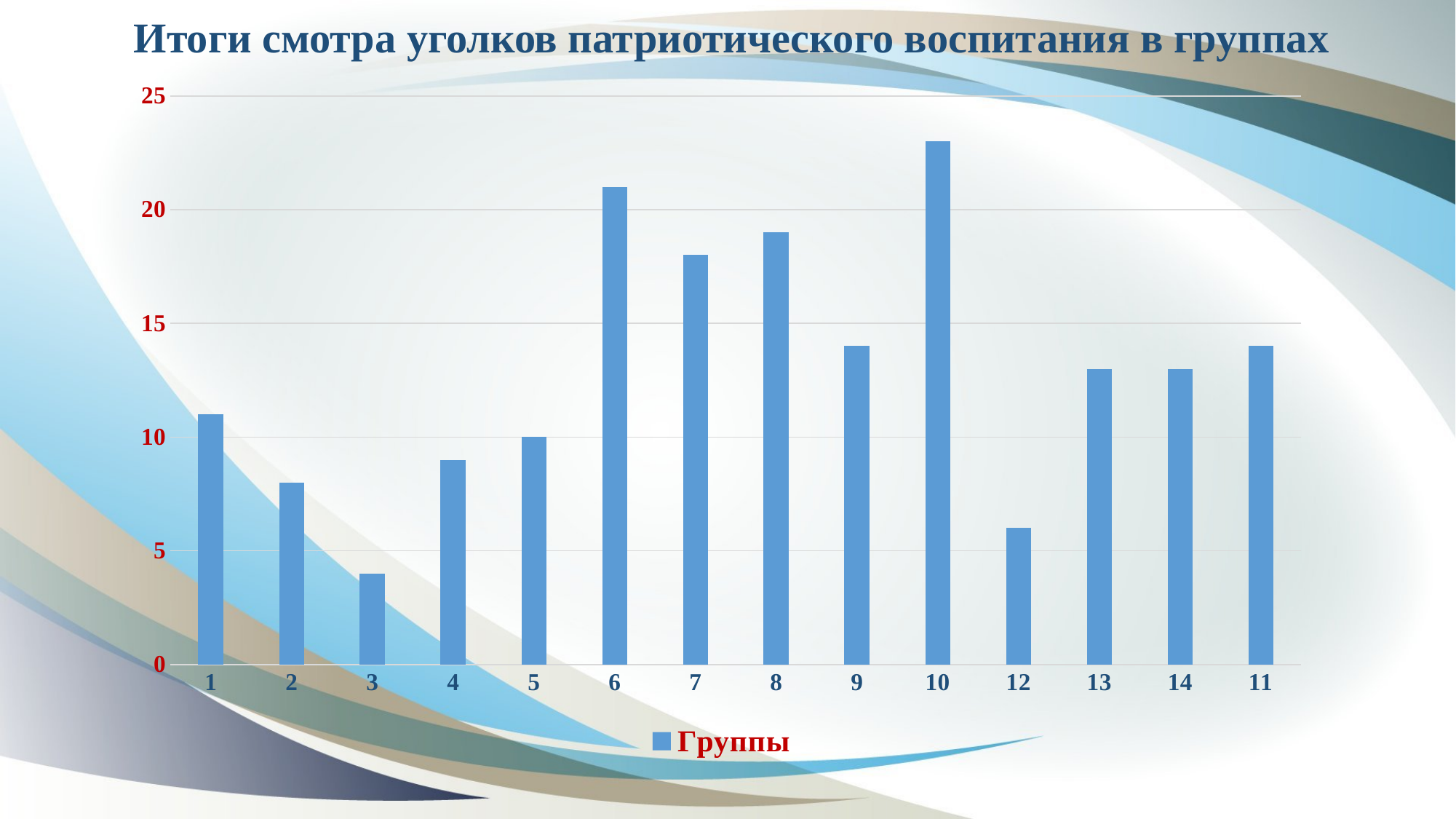
What is the title of the chart? Итоги смотра уголков патриотического воспитания в группах How many series does the legend list? 1 Which group has the highest bar? 10 What is the name of the series shown in the legend? Группы Is the value for group 12 greater or less than 5? greater Which has the larger value, group 6 or group 7? group 6 What is the value for group 5? 10 Which group has the lowest bar? 3 What kind of chart is shown on the slide? bar chart How many groups (categories) are shown on the x axis? 14 Is the value for group 3 greater or less than 5? less Is the value for group 6 greater or less than 20? greater